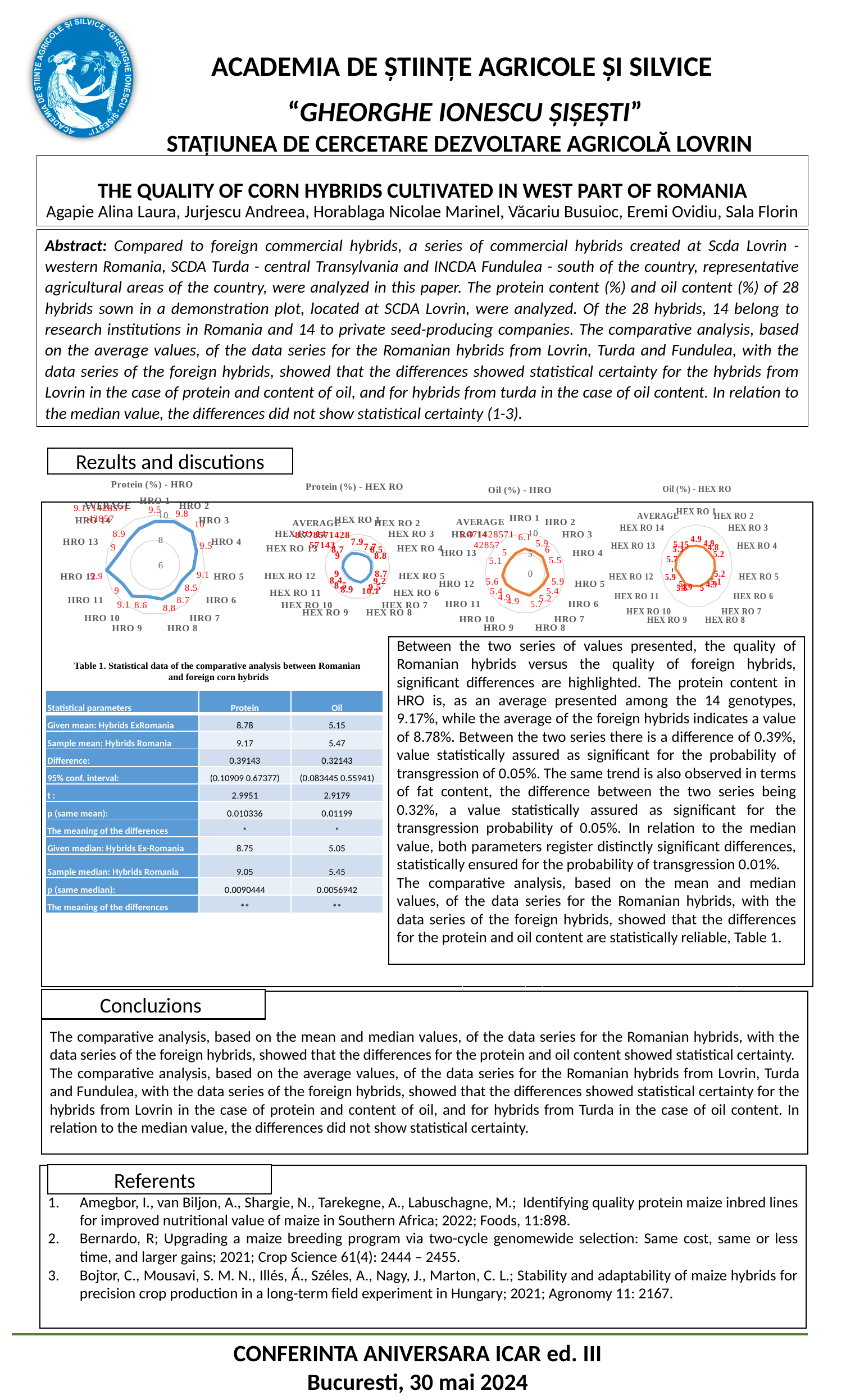
In the "Protein (%) - HRO" chart, what is the value for HRO 3? 10 In the "Oil (%) - HRO" chart, what is the difference between the value for HRO 1 (6.1) and the value for HRO 9 (4.9)? 1.2 In the "Oil (%) - HRO" chart, which is larger, the value for HRO 1 or the value for HRO 9? HRO 1 In the "Oil (%) - HRO" chart, which hybrid has the highest oil value? HRO 1 In the "Protein (%) - HRO" chart, which hybrid has the highest protein value? HRO 3 How many charts are shown in the results section of the slide? 4 In the "Protein (%) - HRO" chart, is the value for HRO 3 greater or less than 8? greater What kind of chart is the "Protein (%) - HRO" chart? Radar chart In the "Oil (%) - HRO" chart, is the value for HRO 1 greater or less than 5? greater In the "Oil (%) - HRO" chart, what is the value for HRO 1? 6.1 What is the title of the chart at the far right of the results section? Oil (%) - HEX RO How many axes (categories) does the "Oil (%) - HRO" radar chart have, including AVERAGE? 15